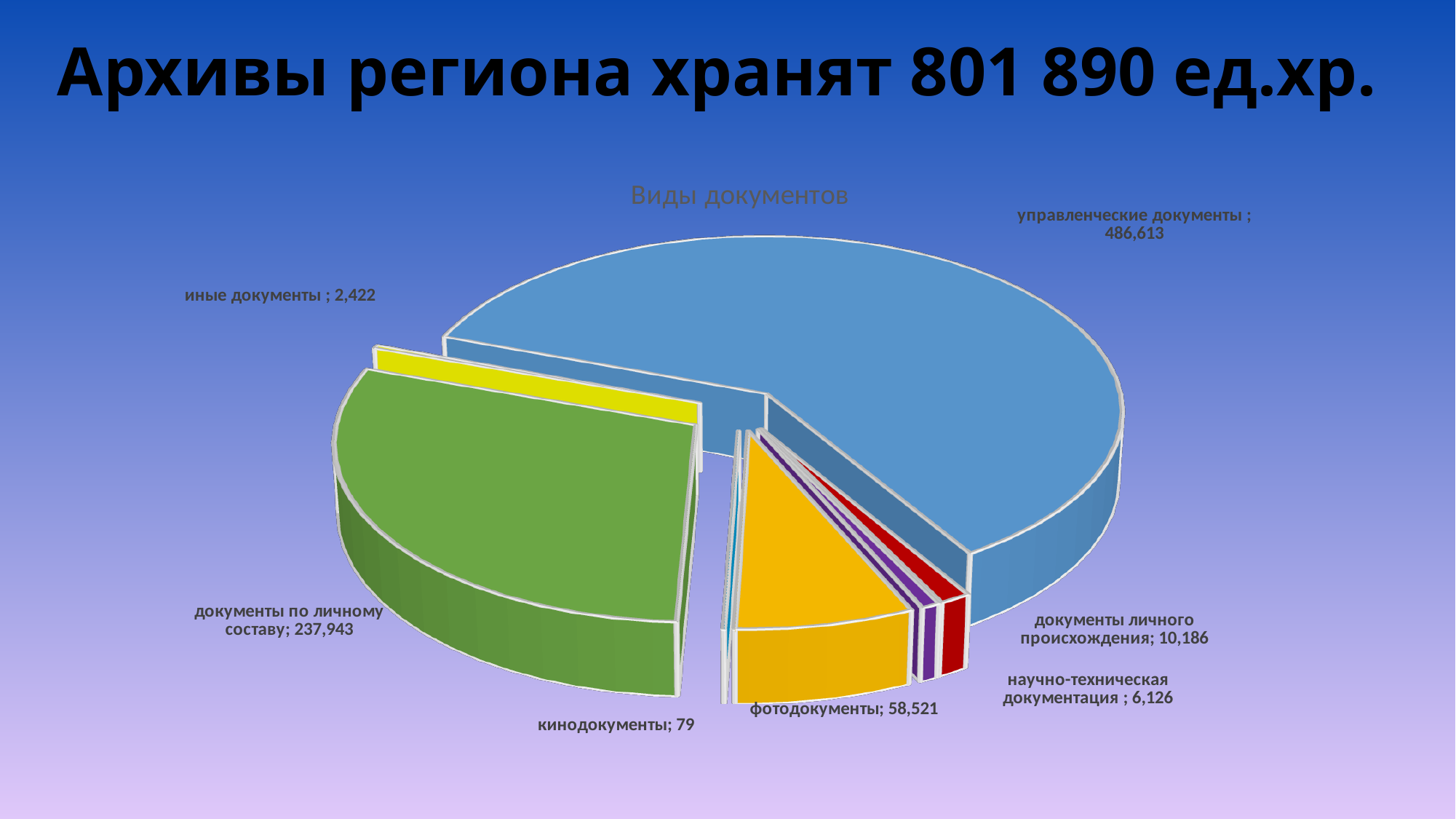
Which category has the largest value? управленческие документы What is the value for документы по личному составу? 237,943 Which is larger: документы личного происхождения or научно-техническая документация? документы личного происхождения What is the value for управленческие документы? 486,613 Which category has the smallest value? кинодокументы What is the value for кинодокументы? 79 What is the difference between управленческие документы and документы по личному составу? 248,670 What type of chart is shown on the slide? pie chart What is the difference between иные документы and кинодокументы? 2,343 What is the title of the chart? Виды документов How many categories (slices) does the pie chart have? 7 What is the value for фотодокументы? 58,521